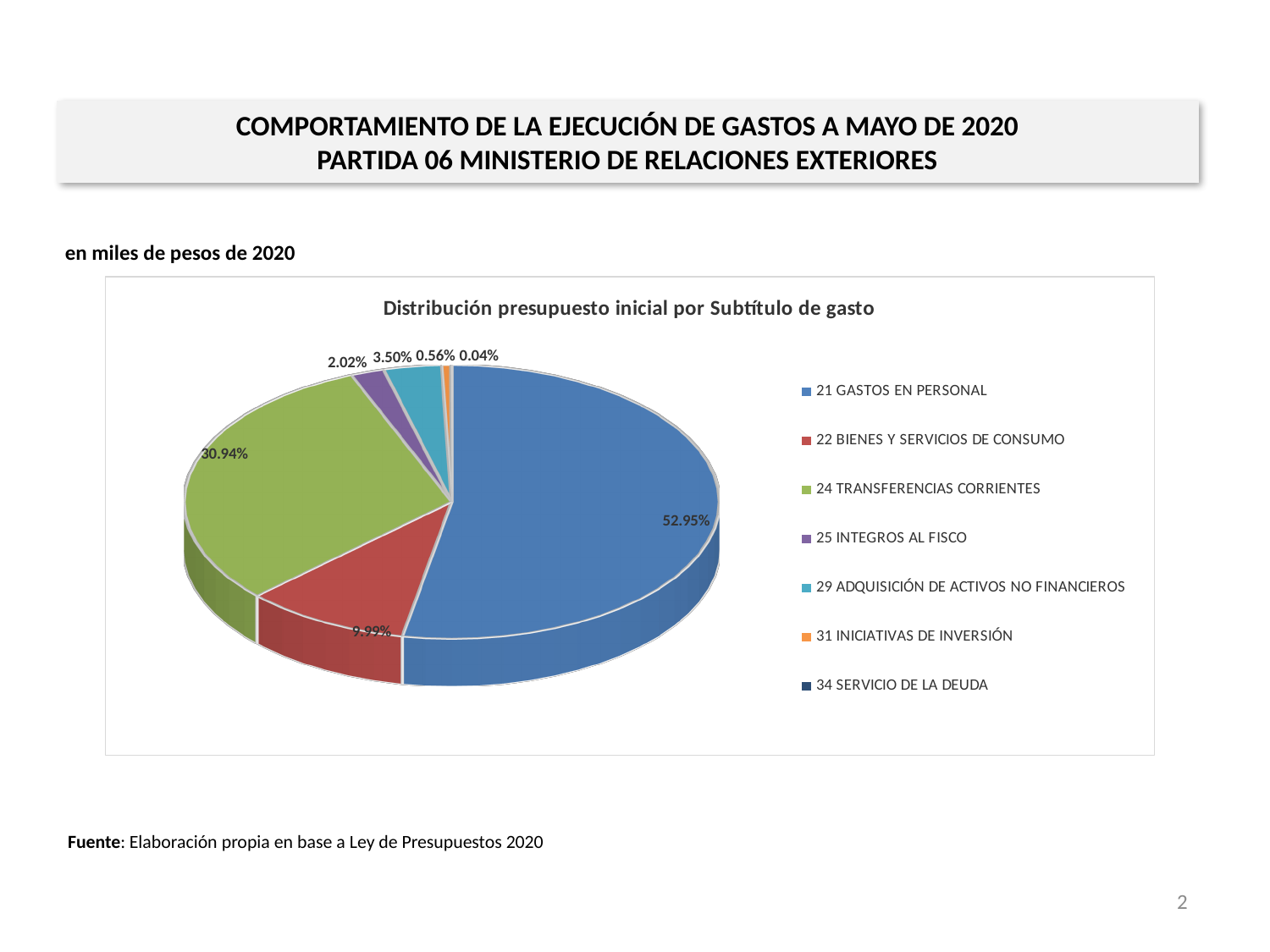
Which has a larger share, 22 BIENES Y SERVICIOS DE CONSUMO or 29 ADQUISICIÓN DE ACTIVOS NO FINANCIEROS? 22 BIENES Y SERVICIOS DE CONSUMO What is the difference in percentage points between the shares of 21 GASTOS EN PERSONAL and 24 TRANSFERENCIAS CORRIENTES? 22.01 What share of the pie does 29 ADQUISICIÓN DE ACTIVOS NO FINANCIEROS represent? 3.50% How many categories does the legend list? 7 What is the title of the chart? Distribución presupuesto inicial por Subtítulo de gasto What kind of chart is shown on the slide? Pie chart What share of the pie does 21 GASTOS EN PERSONAL represent? 52.95% What share of the pie does 25 INTEGROS AL FISCO represent? 2.02% Which category has the largest share of the pie? 21 GASTOS EN PERSONAL Which category has the smallest share of the pie? 34 SERVICIO DE LA DEUDA